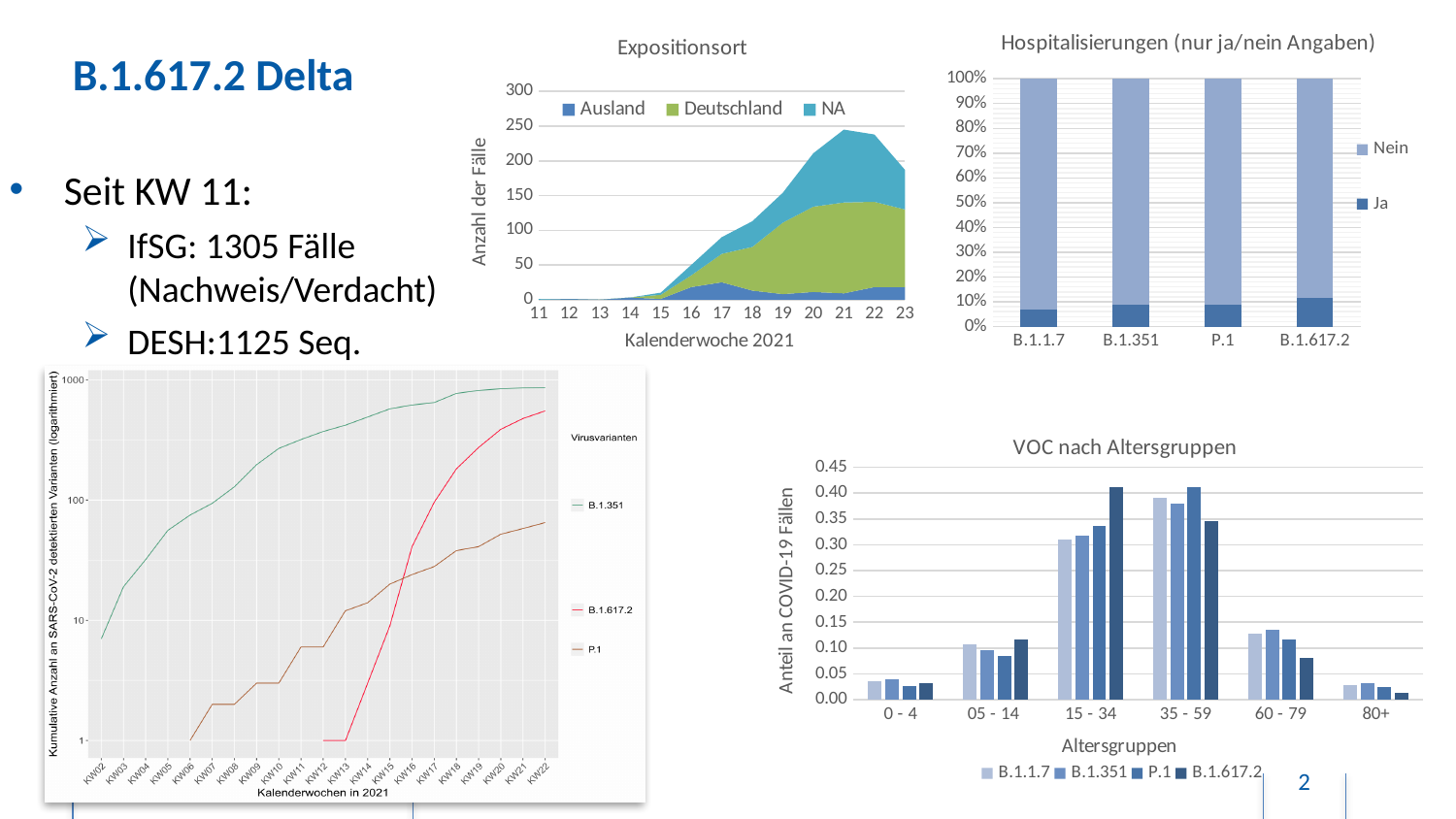
How many variants are shown on the x axis of the 'Hospitalisierungen (nur ja/nein Angaben)' chart? 4 How many age groups are shown on the x axis of the 'VOC nach Altersgruppen' chart? 6 How many series does the legend of the 'Expositionsort' chart list? 3 In the 'VOC nach Altersgruppen' chart, which age group has the highest share for B.1.1.7? 35 - 59 In the 'Hospitalisierungen (nur ja/nein Angaben)' chart, is the 'Ja' share for B.1.617.2 greater or less than 20%? less In the 'Hospitalisierungen (nur ja/nein Angaben)' chart, which variant has the highest share of 'Ja'? B.1.617.2 In the 'VOC nach Altersgruppen' chart, for the 60 - 79 age group, which is larger: B.1.351 or B.1.617.2? B.1.351 What kind of chart is the bottom-left chart showing 'Kumulative Anzahl an SARS-CoV-2 detektierten Varianten'? Line chart In the bottom-left line chart, which variant has the highest cumulative count at KW22? B.1.351 What kind of chart is the 'Expositionsort' chart? Area chart In the 'Expositionsort' chart, is the total number of cases in Kalenderwoche 21 greater or less than 200? greater